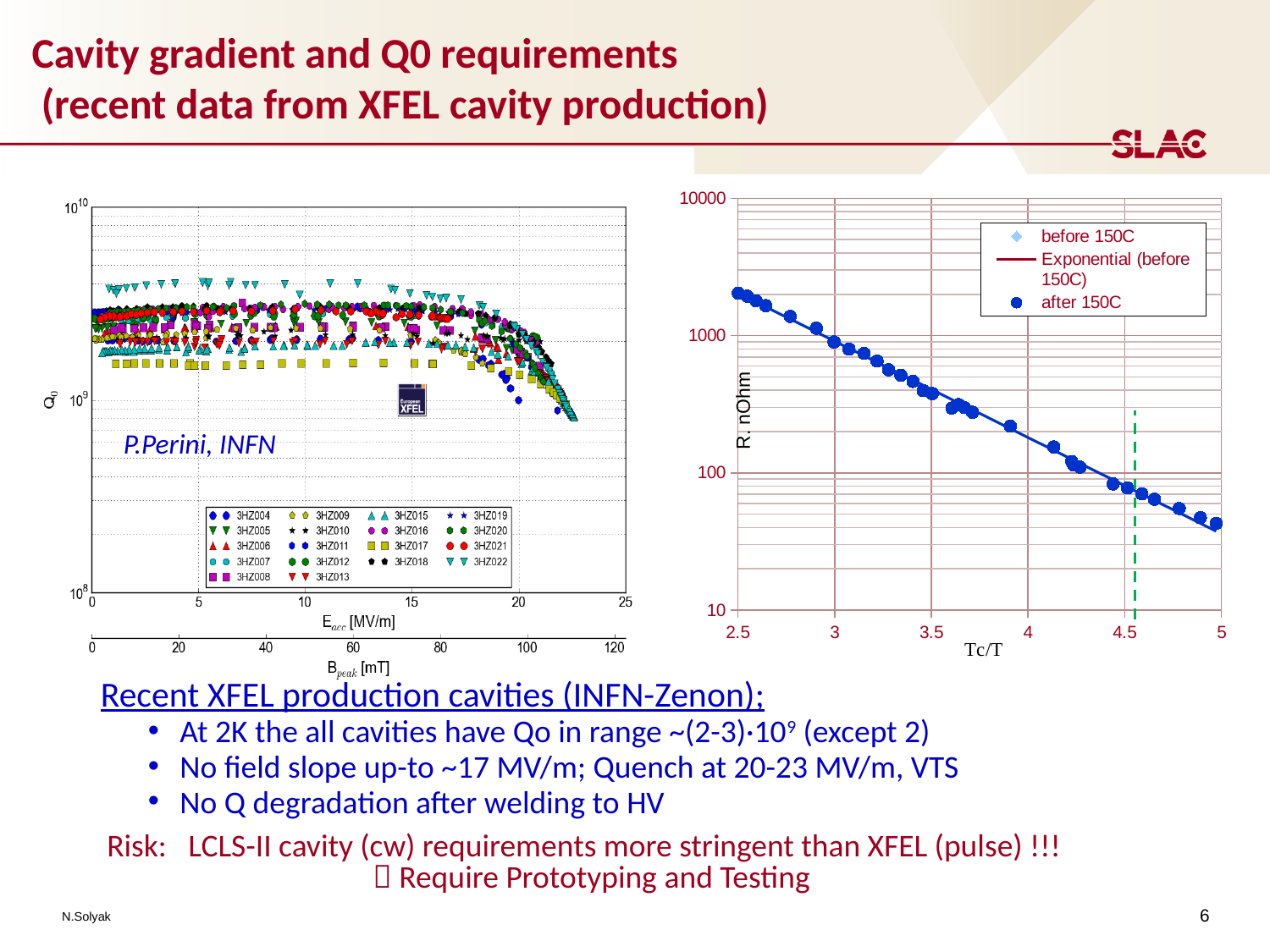
On the right chart, does R (nOhm) rise or fall as Tc/T increases from 2.5 to 5? fall What kind of chart is the right-hand chart of R versus Tc/T? scatter plot On the right chart, what is the label of the x axis? Tc/T On the right chart, is the value of R at Tc/T = 2.5 greater or less than 1000 nOhm? greater On the left chart, is the Q0 value for 3HZ017 at 5 MV/m greater or less than 10^9? greater On the left chart (Q0 vs Eacc), how many cavity series are listed in the legend? 18 On the right chart, is the value of R at Tc/T = 4 greater or less than 1000 nOhm? less On the right chart, what are the three legend entries? before 150C, Exponential (before 150C), after 150C On the left chart, what is the maximum value shown on the Eacc [MV/m] axis? 25 On the right chart (R, nOhm vs Tc/T), how many entries does the legend list? 3 On the left chart, does Q0 rise or fall as Eacc increases beyond about 20 MV/m? fall